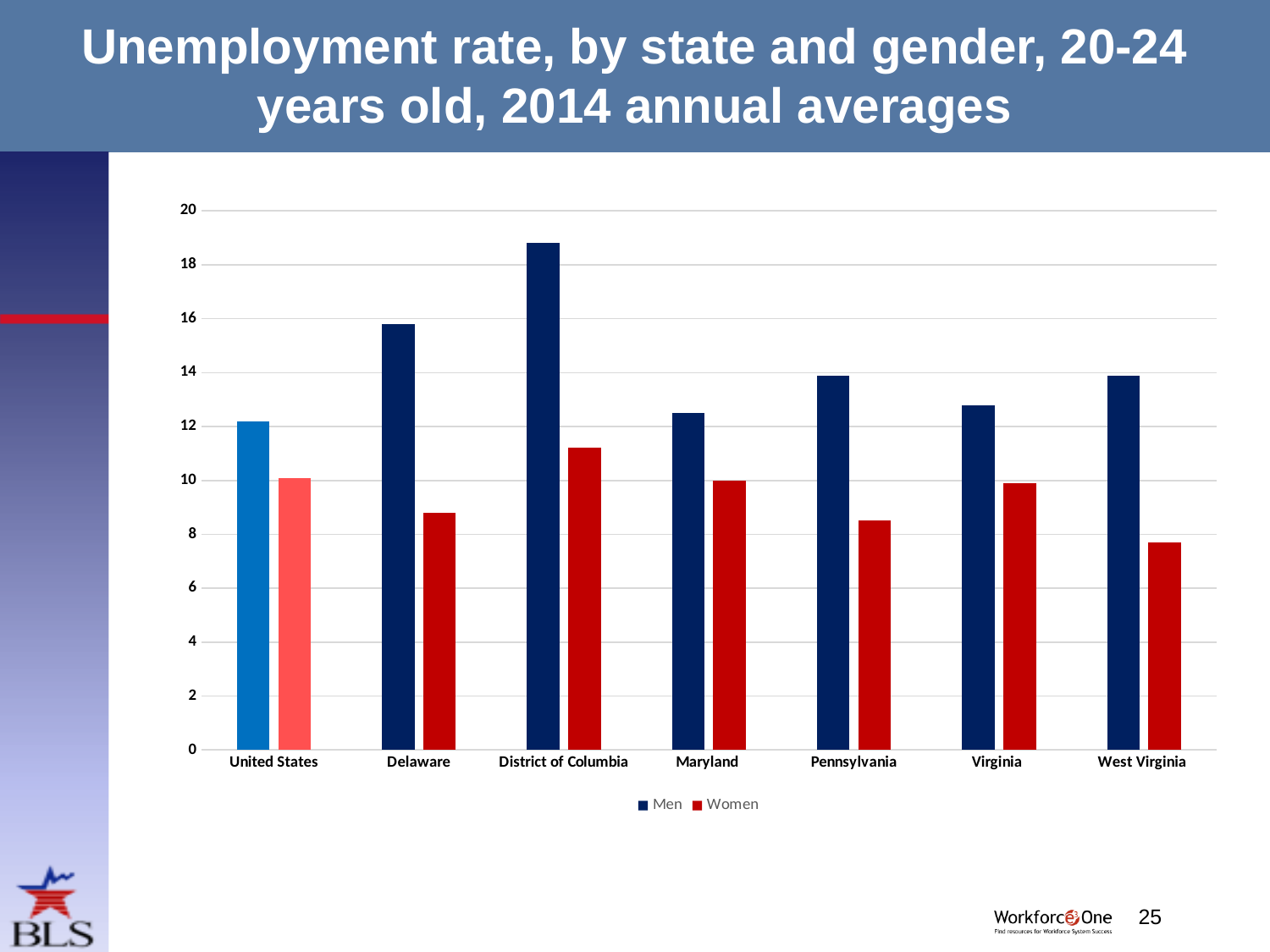
Is the unemployment rate for women in Pennsylvania greater or less than 10? less Is the unemployment rate for men in Delaware greater or less than 14? greater How many series does the chart's legend list? 2 Which is larger, the unemployment rate for men in Delaware or for men in Pennsylvania? Delaware Which is larger, the unemployment rate for women in the District of Columbia or for women in Delaware? District of Columbia Is the unemployment rate for men in the District of Columbia greater or less than 18? greater Which state or area has the highest unemployment rate for women? District of Columbia Which state or area has the highest unemployment rate for men? District of Columbia What are the two series named in the chart's legend? Men and Women How many states or areas are shown along the x axis of the chart? 7 What kind of chart is shown on the slide? bar chart Which state or area has the lowest unemployment rate for women? West Virginia